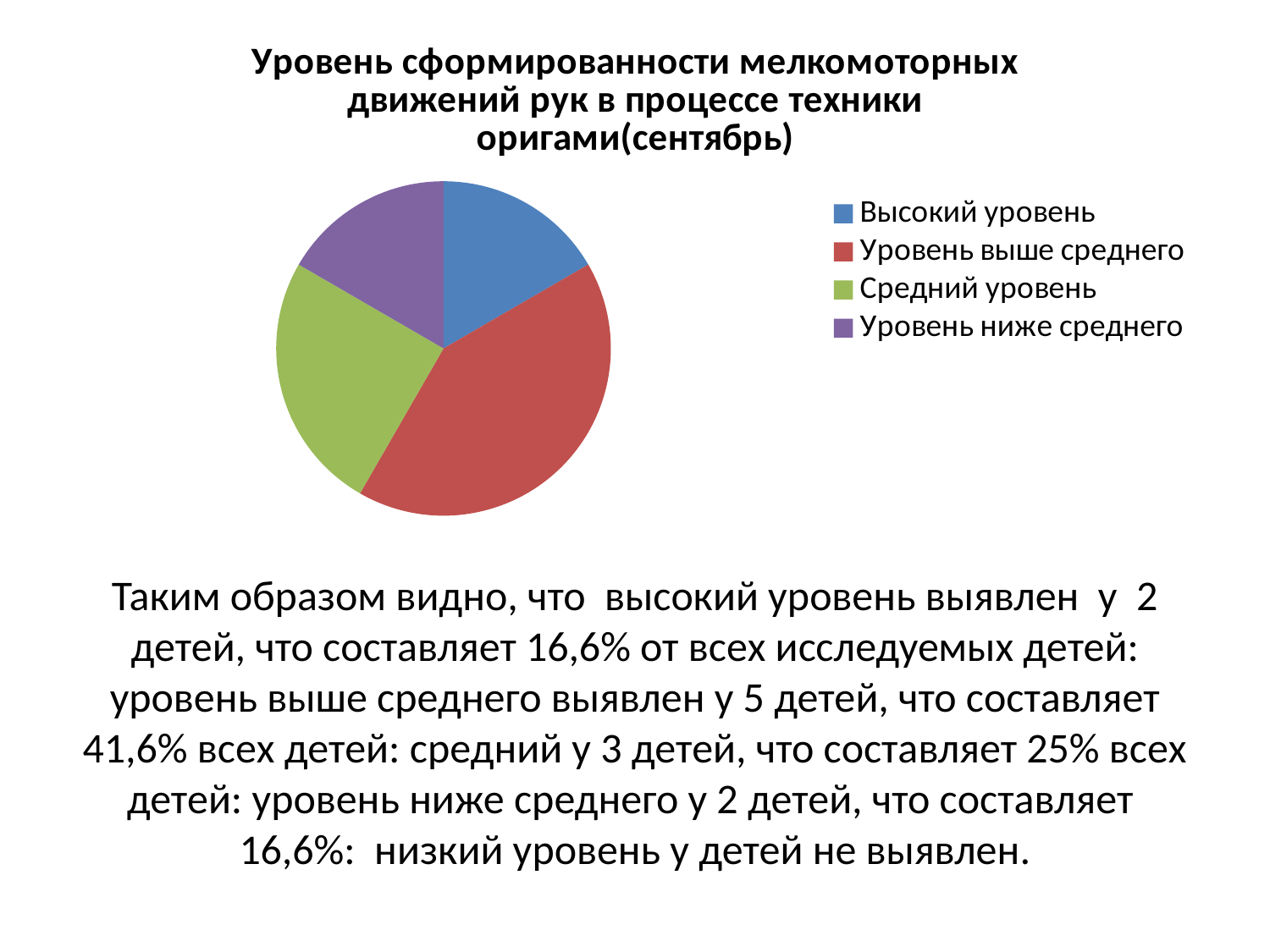
How many slices does the pie chart have? 4 What colour is the slice for Средний уровень in the pie chart? green Which slice is larger: Средний уровень or Высокий уровень? Средний уровень Which category has the largest slice in the pie chart? Уровень выше среднего What kind of chart is shown on the slide? pie chart Which legend entry is shown in red in the pie chart? Уровень выше среднего How many entries does the legend of the pie chart list? 4 Which slice is larger: Уровень выше среднего or Средний уровень? Уровень выше среднего Which slice is larger: Уровень выше среднего or Уровень ниже среднего? Уровень выше среднего